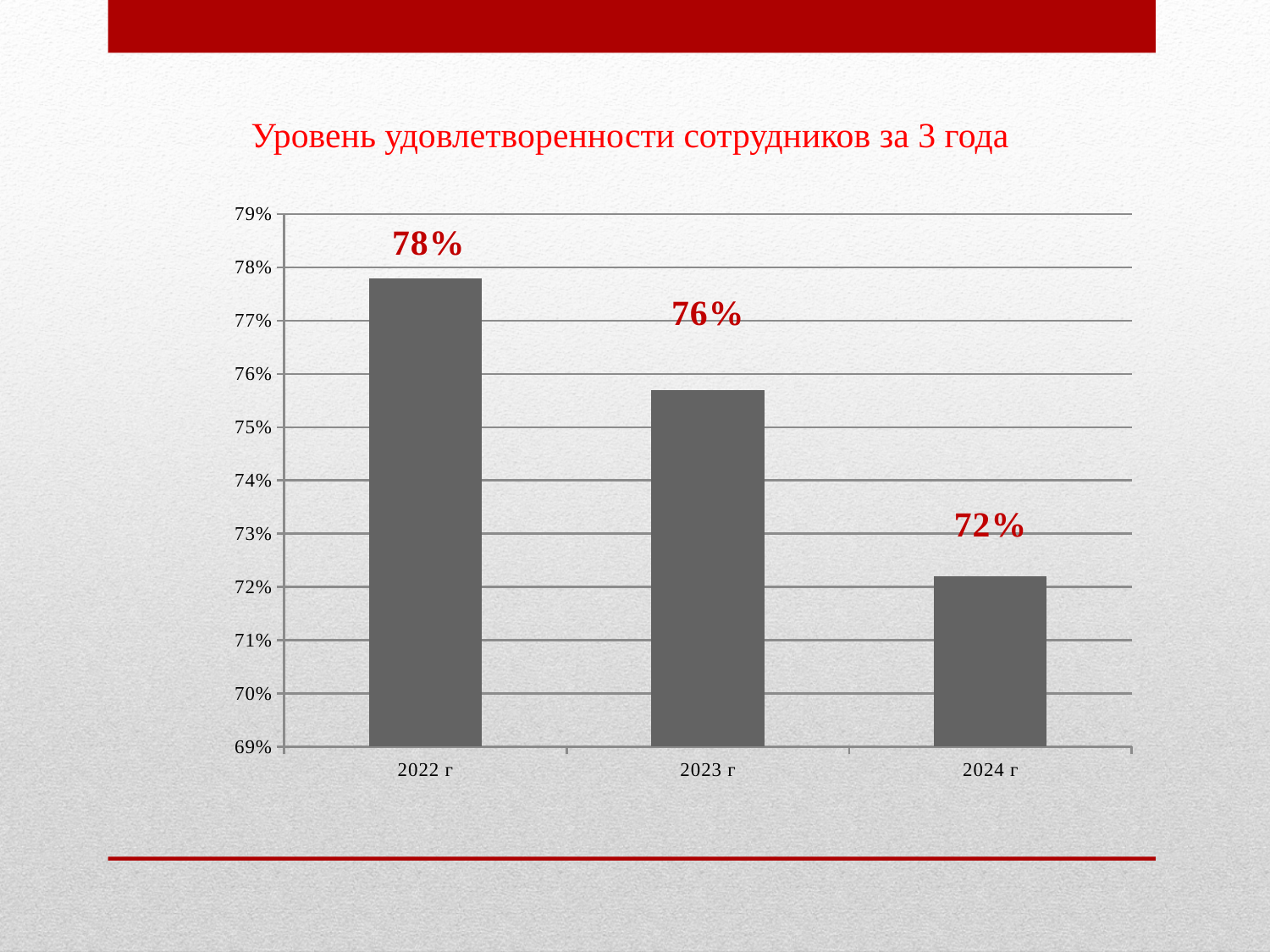
What is the employee satisfaction level for 2024 г? 72% Which year has the lowest satisfaction level? 2024 г What is the employee satisfaction level for 2022 г? 78% What is the employee satisfaction level for 2023 г? 76% What is the difference between the labelled values for 2022 г and 2024 г? 6% How many years are shown on the chart? 3 Which year has the highest satisfaction level? 2022 г Is the value for 2024 г greater or less than 75%? less What is the difference between the labelled values for 2023 г and 2024 г? 4% Which is larger, the value for 2022 г or the value for 2023 г? 2022 г Do the values rise or fall from 2022 г to 2024 г? fall What kind of chart is shown on the slide? bar chart